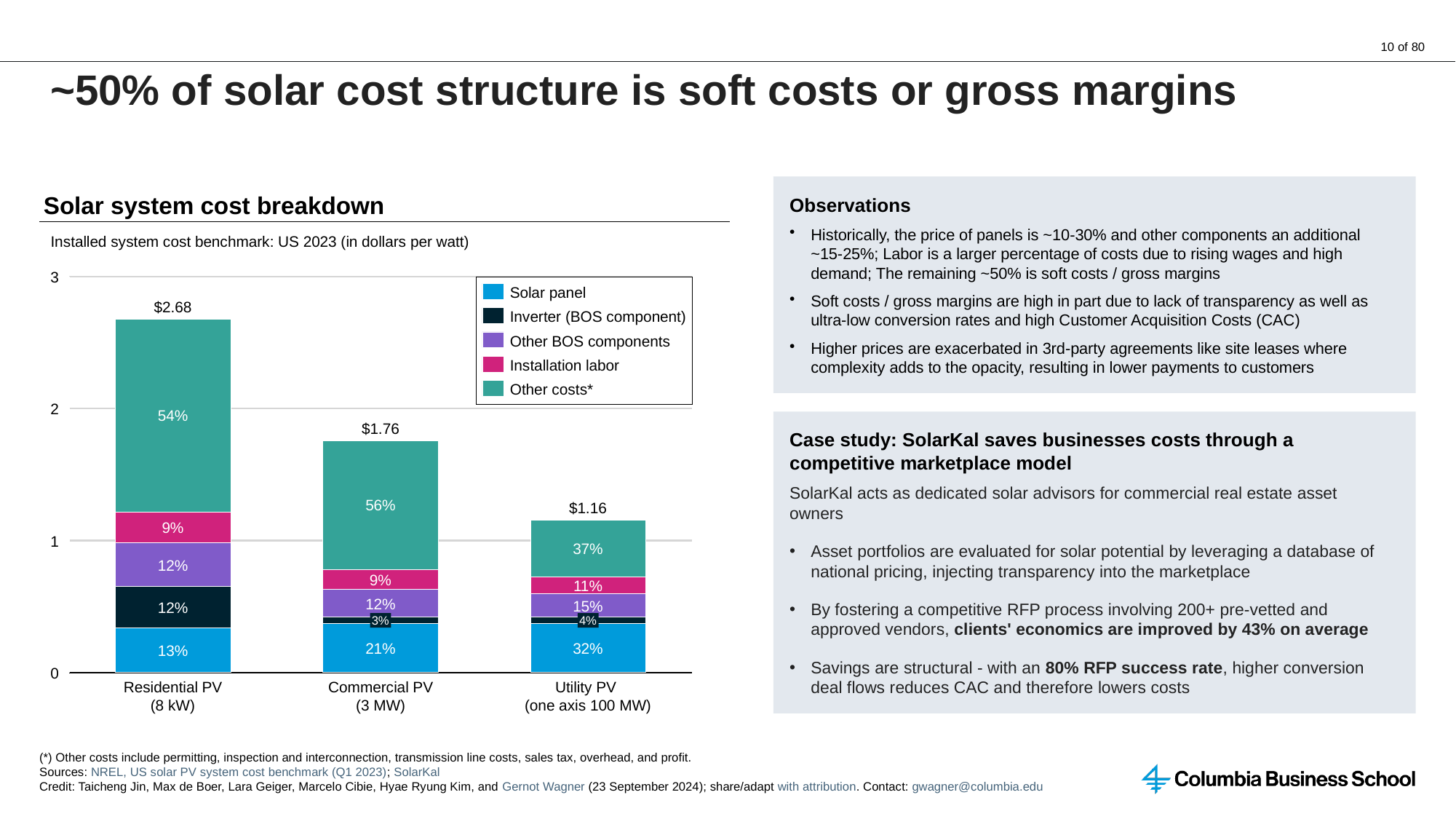
How many cost components does the legend list? 5 What percentage of the Utility PV (one axis 100 MW) cost is the Solar panel? 32% Which system type has the lowest total installed cost per watt? Utility PV (one axis 100 MW) What percentage of the Commercial PV (3 MW) cost is Other costs*? 56% Do the total installed costs rise or fall moving from Residential PV to Utility PV along the x axis? fall What is the total installed system cost shown above the Residential PV (8 kW) bar? $2.68 Which has a larger Solar panel share of cost, Residential PV (8 kW) or Commercial PV (3 MW)? Commercial PV (3 MW) What is the total installed system cost shown above the Utility PV (one axis 100 MW) bar? $1.16 How many system types (bars) are shown in the chart? 3 Which system type has the highest total installed cost per watt? Residential PV (8 kW) What is the difference in total installed cost between Residential PV (8 kW) and Utility PV (one axis 100 MW)? $1.52 What percentage of the Residential PV (8 kW) cost is Installation labor? 9%